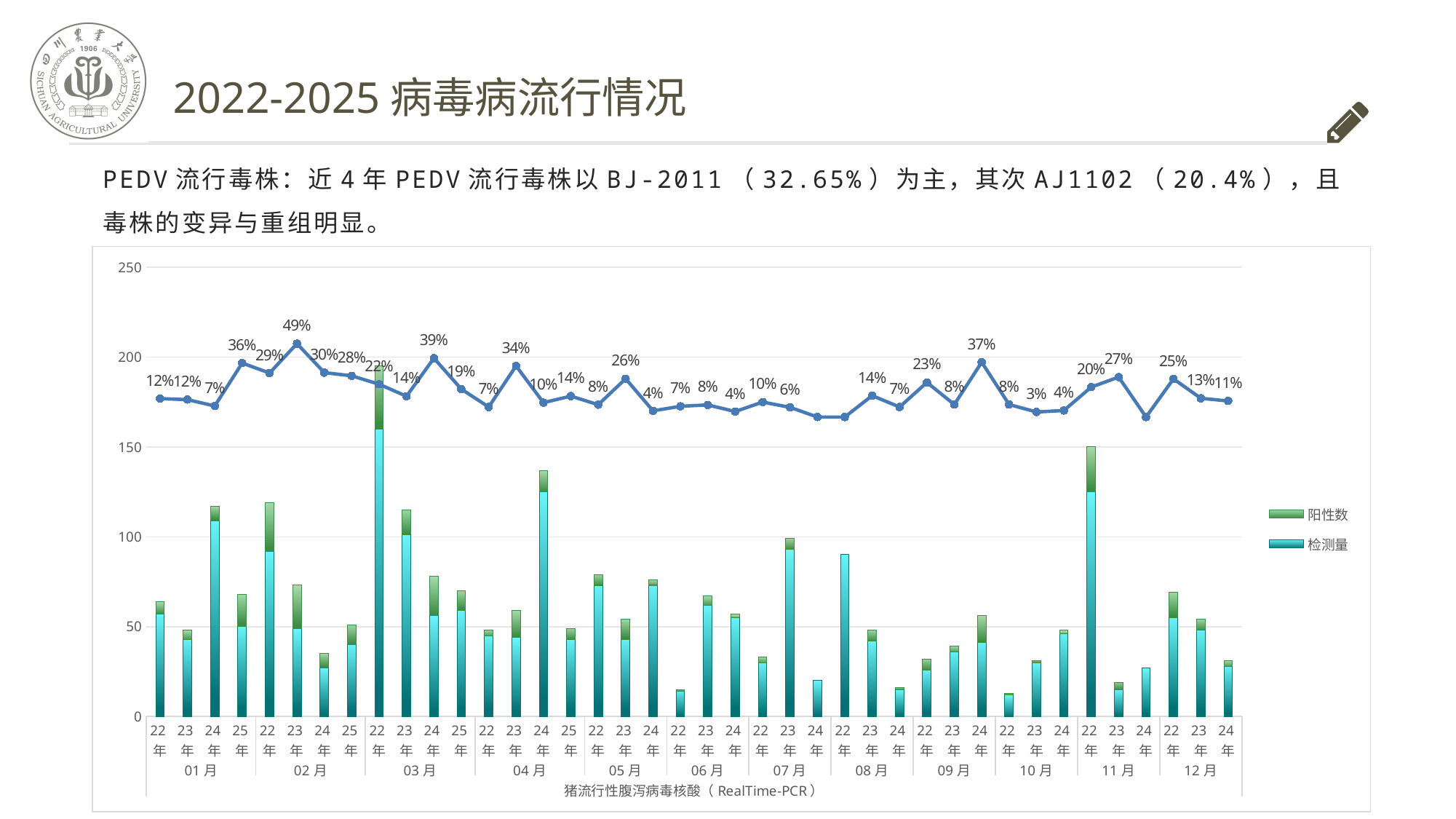
What is the percentage label shown for 24年 in 09月? 37% What is the percentage label shown for 22年 in 01月? 12% How many series does the legend list? 2 What kind of chart is shown on the slide? Stacked bar chart with a line Is the 检测量 value for 22年 in 11月 greater or less than 100? greater Which has the larger percentage label: 22年 in 04月 or 22年 in 05月? 22年 in 05月 (8%) What are the two series named in the legend? 阳性数 and 检测量 What is the difference between the percentage labels for 24年 in 03月 (39%) and 25年 in 03月 (19%)? 20% Which month and year has the highest percentage label on the line? 02月 23年 (49%) What is the percentage label shown for 23年 in 02月? 49% Which month and year has the lowest percentage label on the line? 10月 23年 (3%) How many year-month categories are shown on the x axis? 40